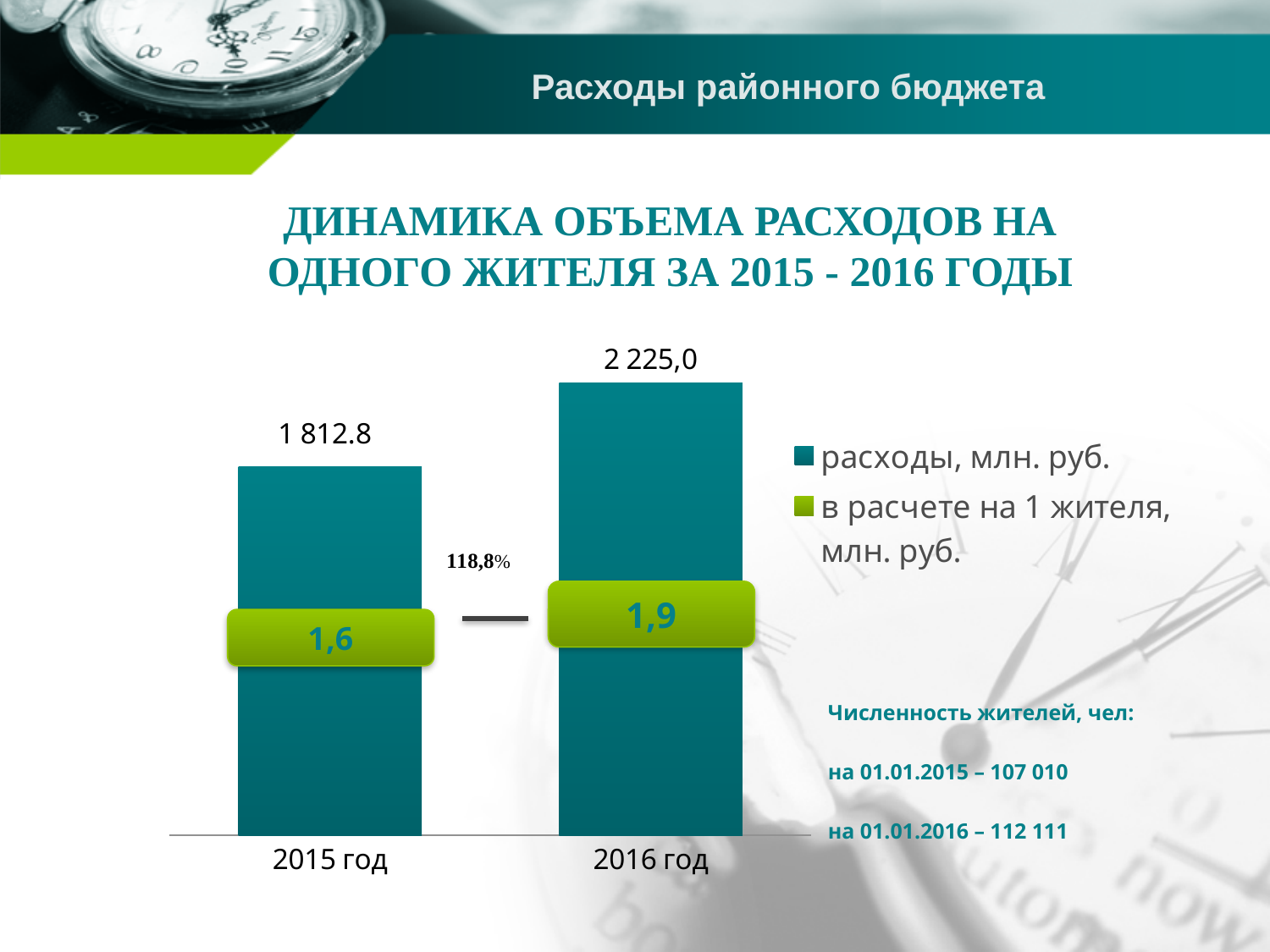
Is the value of расходы, млн. руб. larger for 2015 год or 2016 год? 2016 год By how much does в расчете на 1 жителя, млн. руб. in 2016 год exceed that in 2015 год? 0,3 How many series does the legend list? 2 What is the value of расходы, млн. руб. for 2015 год? 1 812.8 What is the value of в расчете на 1 жителя, млн. руб. for 2015 год? 1,6 Which year has the lower value of в расчете на 1 жителя, млн. руб.? 2015 год What is the value of расходы, млн. руб. for 2016 год? 2 225,0 What type of chart is shown on the slide? bar chart Do the values of расходы, млн. руб. rise or fall from 2015 год to 2016 год? rise What is the value of в расчете на 1 жителя, млн. руб. for 2016 год? 1,9 How many categories (years) are shown on the x axis? 2 Which year has the higher value of расходы, млн. руб.? 2016 год